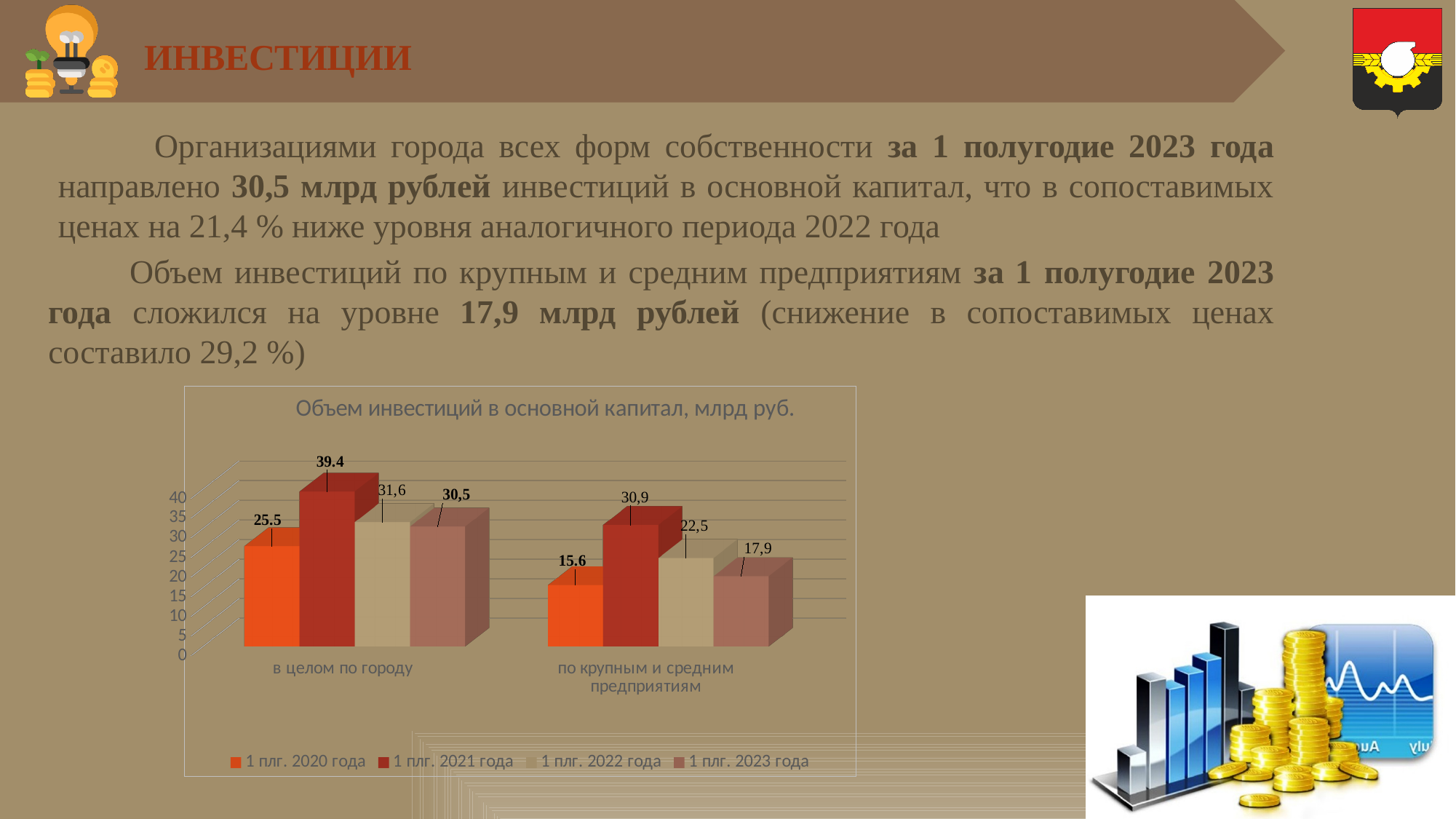
Which is larger: the '1 плг. 2020 года' value for 'в целом по городу' or the '1 плг. 2020 года' value for 'по крупным и средним предприятиям'? в целом по городу What is the difference between the '1 плг. 2022 года' and '1 плг. 2023 года' values in the category 'в целом по городу'? 1,1 What is the value for '1 плг. 2020 года' in the category 'по крупным и средним предприятиям'? 15.6 What is the difference between the '1 плг. 2022 года' and '1 плг. 2023 года' values in the category 'по крупным и средним предприятиям'? 4,6 Which series has the highest value in the category 'в целом по городу'? 1 плг. 2021 года What is the value for '1 плг. 2023 года' in the category 'по крупным и средним предприятиям'? 17,9 Which series has the lowest value in the category 'по крупным и средним предприятиям'? 1 плг. 2020 года What is the value for '1 плг. 2021 года' in the category 'в целом по городу'? 39.4 What is the value for '1 плг. 2022 года' in the category 'в целом по городу'? 31,6 How many categories are shown on the x axis? 2 How many series does the legend list? 4 What kind of chart is shown on the slide? Bar chart